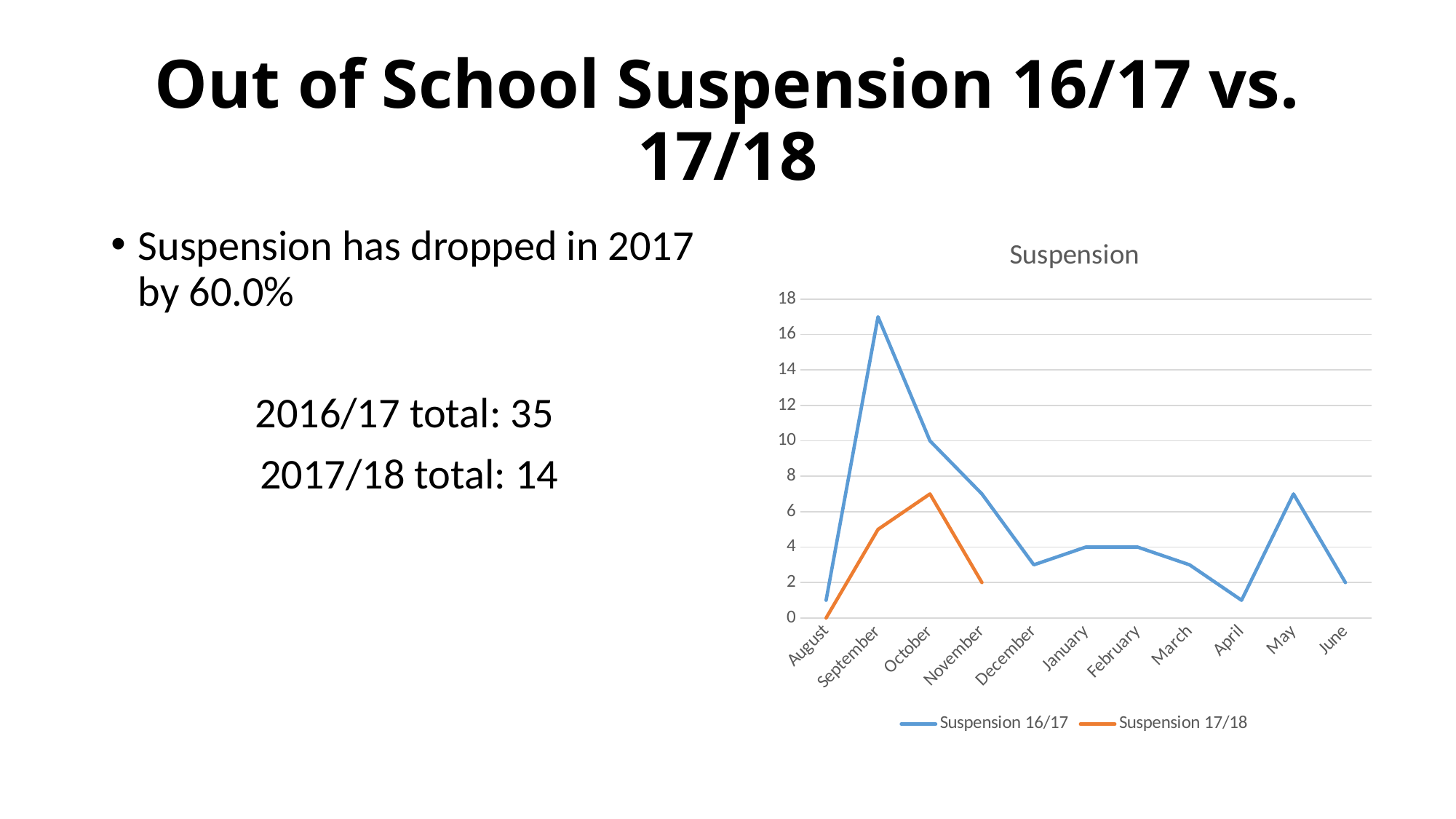
Does the Suspension 17/18 series rise or fall from October to November? fall How many series does the chart legend list? 2 What is the title of the chart? Suspension In which month does the Suspension 17/18 series reach its highest value? October Is the Suspension 16/17 value for September greater or less than 16? greater Is the Suspension 16/17 value for April greater or less than 2? less How many months are shown on the x axis of the chart? 11 Is the Suspension 17/18 value for October greater or less than 6? greater Which series has the larger value in September, Suspension 16/17 or Suspension 17/18? Suspension 16/17 What kind of chart is shown on the slide? line chart In which month is the Suspension 17/18 series at its lowest value? August In which month does the Suspension 16/17 series reach its highest value? September